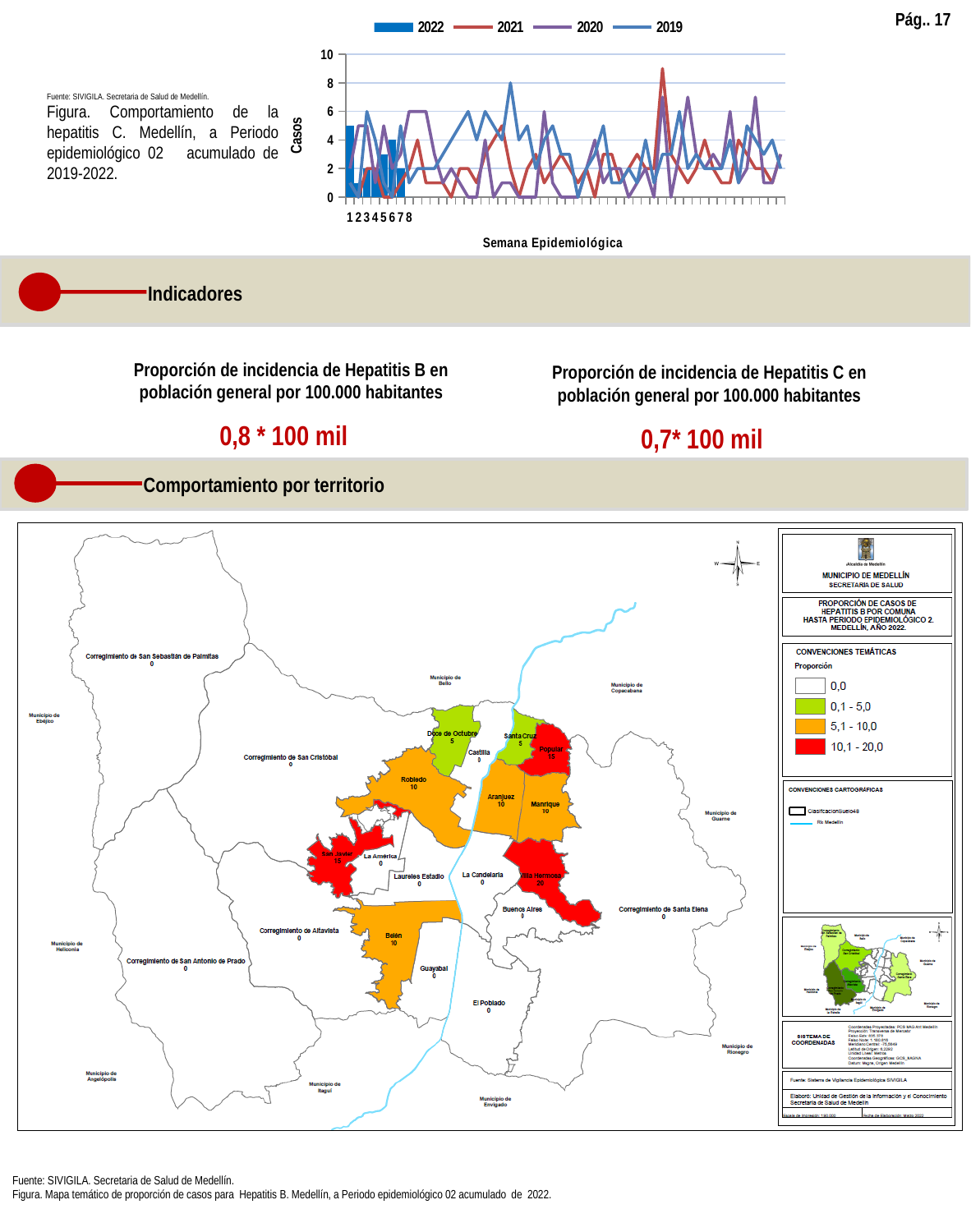
Is the highest value reached by the 2021 series on the hepatitis C chart greater or less than 8? greater How many series does the legend of the hepatitis C chart list? 4 Is the tallest 2022 bar on the hepatitis C chart greater or less than 6? less Which series reaches the highest single peak on the hepatitis C chart? 2021 What is the label of the vertical axis on the hepatitis C chart? Casos What is the highest tick value shown on the vertical axis of the hepatitis C chart? 10 What is the label of the horizontal axis on the hepatitis C chart? Semana Epidemiológica Which series on the hepatitis C chart is drawn as bars rather than a line? 2022 Is the highest value reached by the 2020 series on the hepatitis C chart greater or less than 8? less What kind of chart is used to show the hepatitis C cases by epidemiological week? A combined bar and line chart